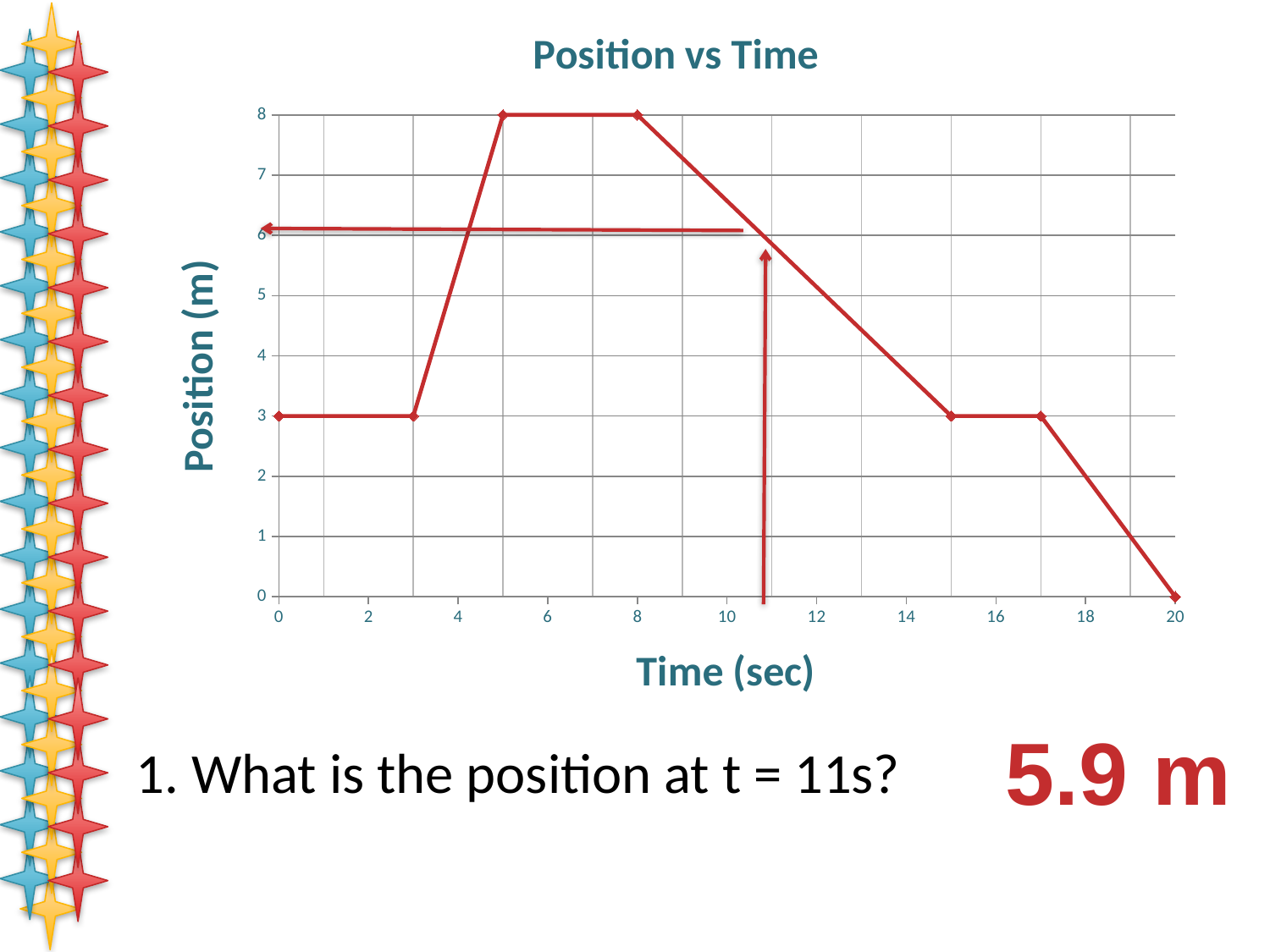
How many data points are plotted on the line? 7 What kind of chart is shown on the slide? line chart Which is larger, the position at t = 5 seconds or at t = 15 seconds? t = 5 seconds What is the highest position value reached on the chart? 8 What is the label of the vertical axis? Position (m) At what time does the position reach its lowest value? 20 What is the difference between the position at t = 5 seconds and the position at t = 17 seconds? 5 What is the position at t = 20 seconds? 0 What is the position at t = 0 seconds? 3 What is the position at t = 8 seconds? 8 Does the position rise or fall between t = 8 and t = 15 seconds? fall What is the title of the chart? Position vs Time